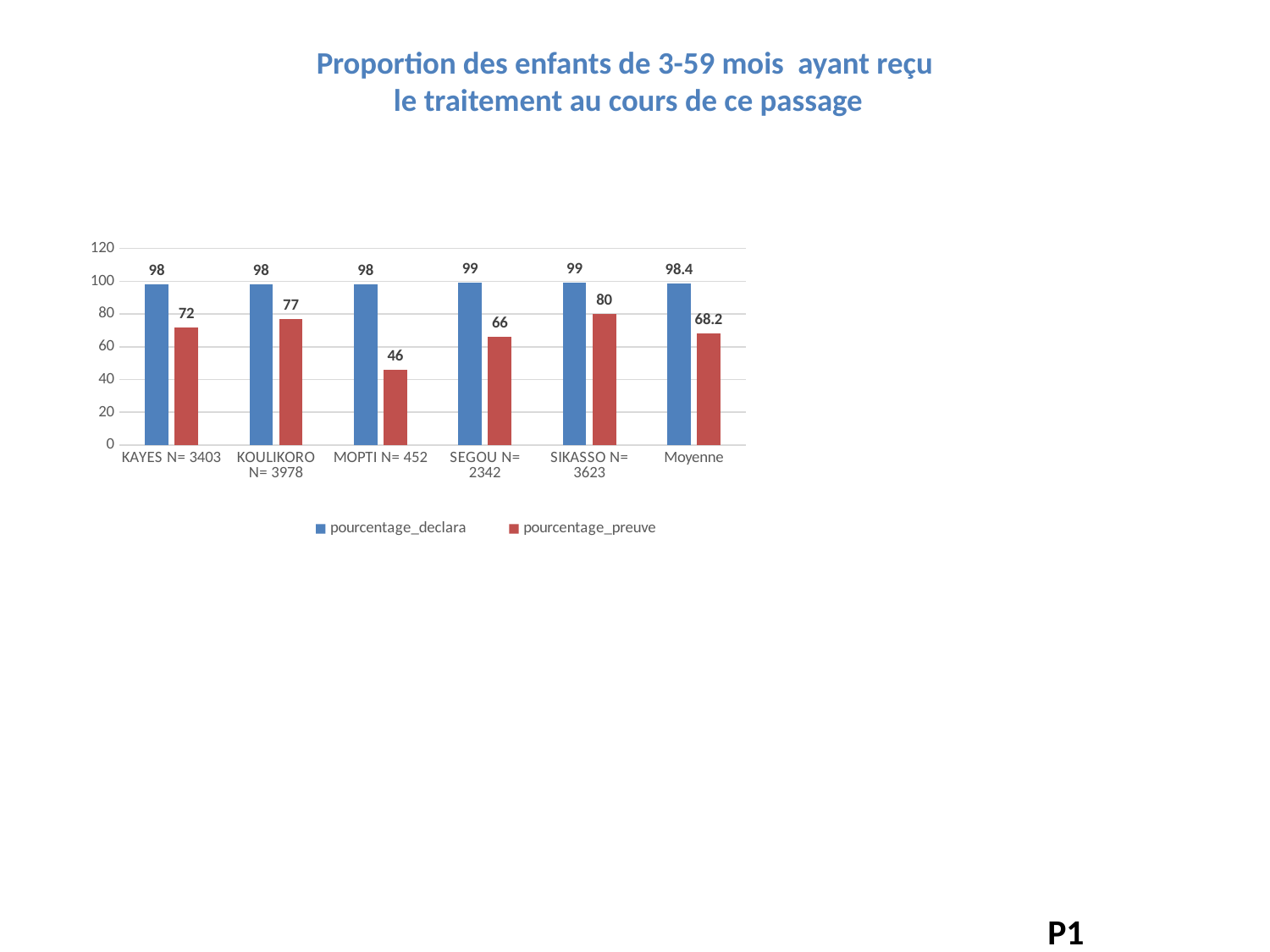
Which colour represents the pourcentage_preuve series? red How many categories are shown on the x axis? 6 Which category has the lowest pourcentage_preuve value? MOPTI N= 452 What is the pourcentage_declara value for Moyenne? 98.4 What is the difference between pourcentage_declara and pourcentage_preuve for KAYES N= 3403? 26 What is the difference between the pourcentage_preuve values for SIKASSO N= 3623 and MOPTI N= 452? 34 Which is larger, the pourcentage_preuve value for KOULIKORO N= 3978 or for SEGOU N= 2342? KOULIKORO N= 3978 How many series does the legend list? 2 What kind of chart is shown on the slide? bar chart Which category has the highest pourcentage_preuve value? SIKASSO N= 3623 What is the pourcentage_preuve value for MOPTI N= 452? 46 What is the pourcentage_preuve value for SIKASSO N= 3623? 80